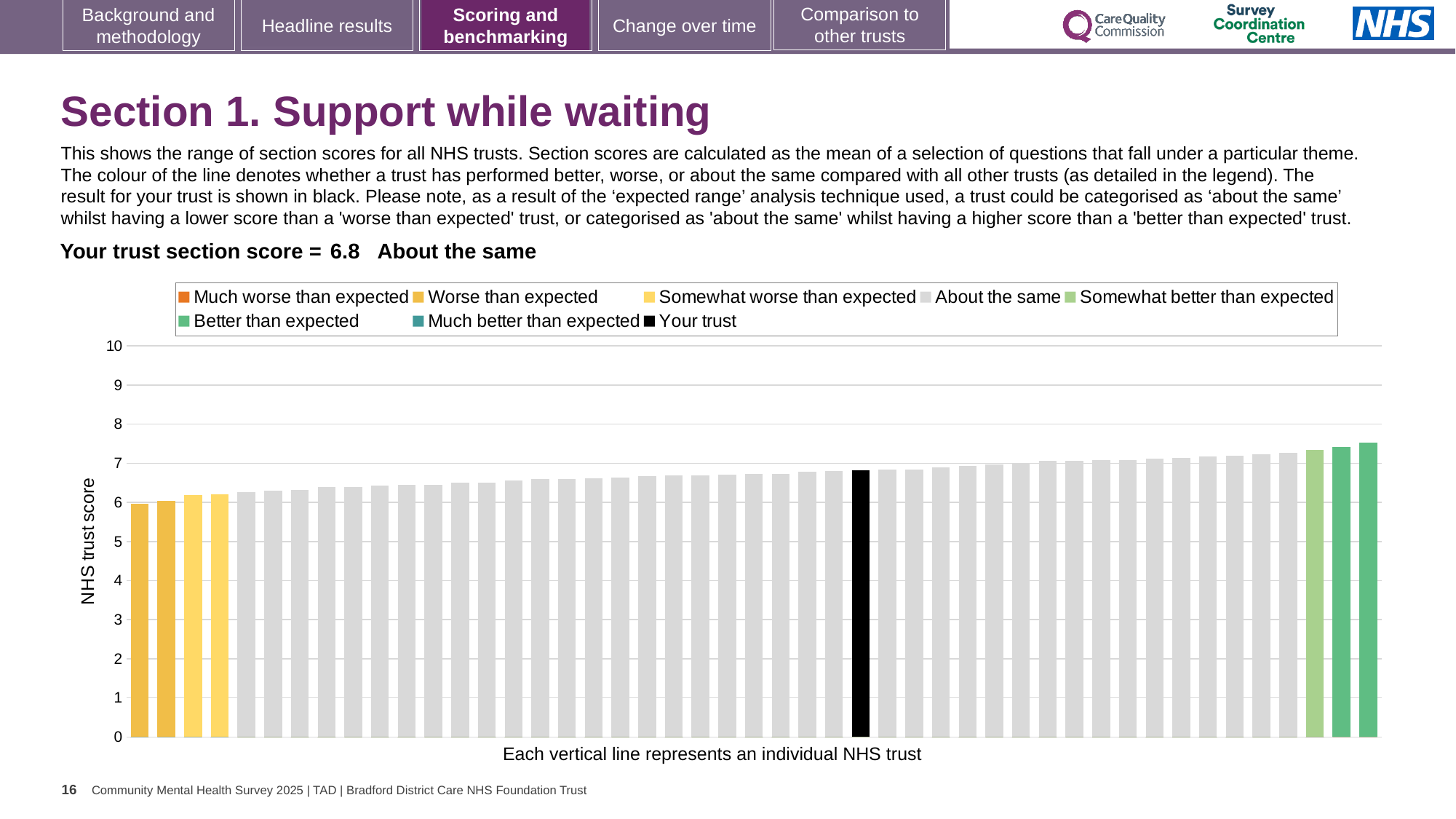
Is the value of the lowest bar (leftmost) greater or less than 5? greater What kind of chart is shown on the slide? bar chart Do the bar values rise or fall from left to right along the x axis? rise What is the label on the vertical axis of the chart? NHS trust score What is the section score for your trust shown on the slide? 6.8 Which is larger, the leftmost bar or the black bar for your trust? the black bar (your trust) Which legend category does the highest bar on the chart belong to? Better than expected Is the value for your trust (the black bar) greater or less than 5? greater How many bars are coloured as 'Better than expected' (dark green)? 2 Which legend category does the lowest bar on the chart belong to? Worse than expected How many entries does the chart legend list? 8 Is the value of the highest bar (rightmost) greater or less than 8? less